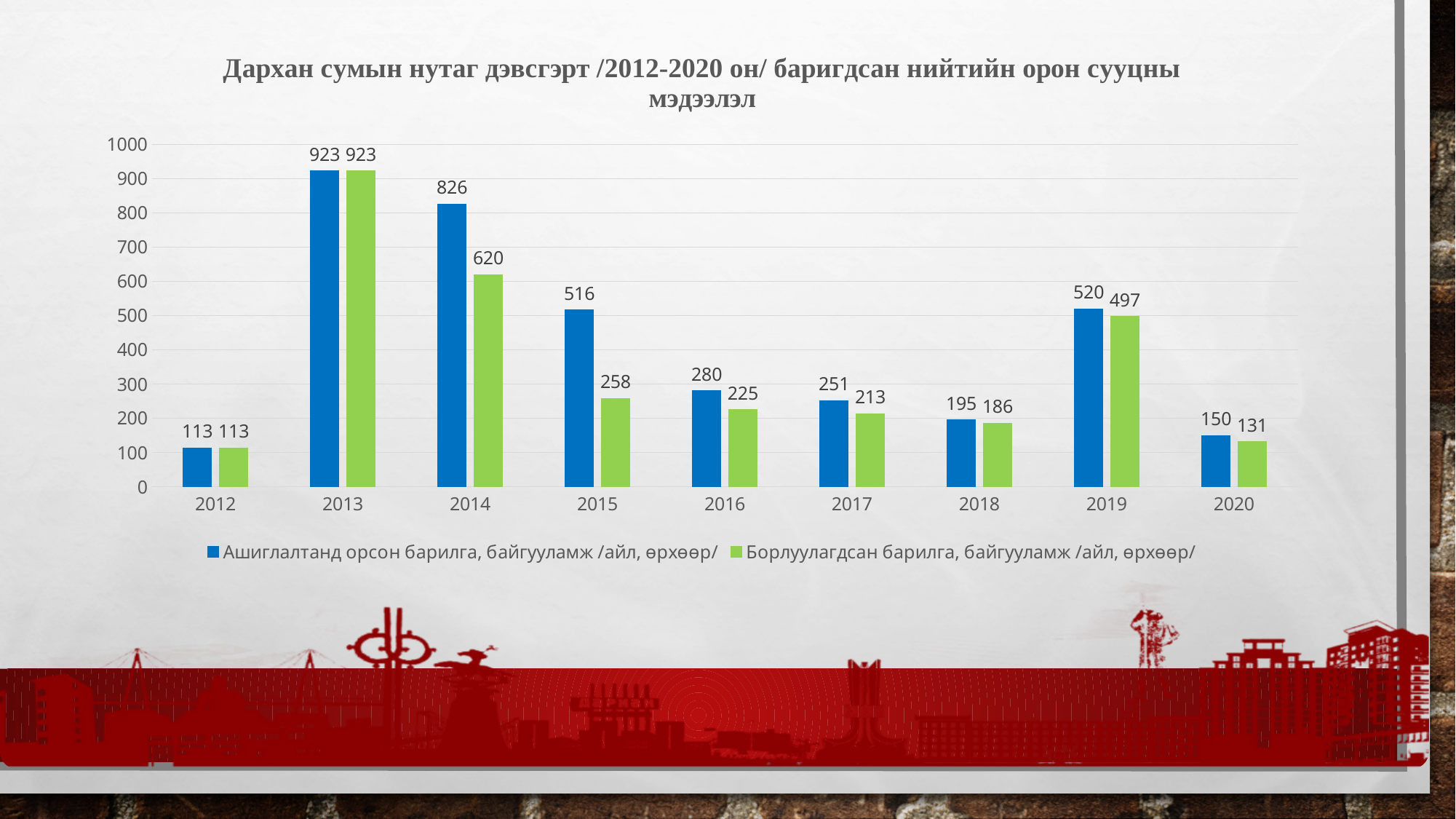
What type of chart is shown on the slide? bar chart Which series has the larger value in 2019? Ашиглалтанд орсон барилга, байгууламж /айл, өрхөөр/ Is the value for 'Ашиглалтанд орсон барилга, байгууламж /айл, өрхөөр/' in 2016 greater or less than 300? less In which year is the value for 'Ашиглалтанд орсон барилга, байгууламж /айл, өрхөөр/' highest? 2013 What is the difference between the two series' values in 2014? 206 What is the value for 'Ашиглалтанд орсон барилга, байгууламж /айл, өрхөөр/' in 2014? 826 Do the values for 'Борлуулагдсан барилга, байгууламж /айл, өрхөөр/' rise or fall from 2014 to 2018? fall How many series does the legend list? 2 What colour are the bars for 'Борлуулагдсан барилга, байгууламж /айл, өрхөөр/'? green What is the value for 'Борлуулагдсан барилга, байгууламж /айл, өрхөөр/' in 2015? 258 In which year is the value for 'Борлуулагдсан барилга, байгууламж /айл, өрхөөр/' lowest? 2012 How many years are shown on the x axis? 9